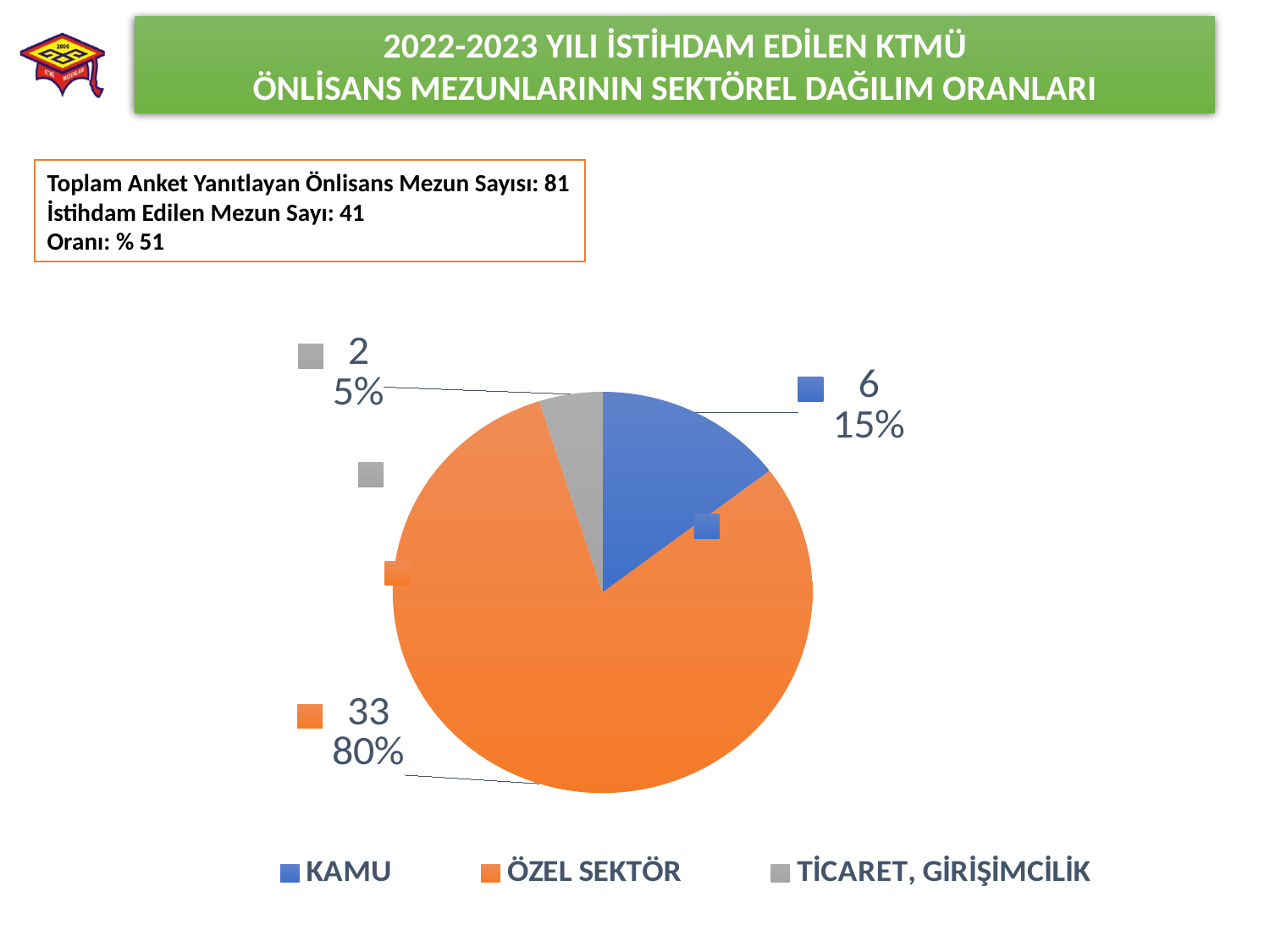
Which category has the largest slice in the pie chart? ÖZEL SEKTÖR What type of chart is shown on the slide? pie chart How many entries does the legend of the pie chart list? 3 Which category has the smallest slice in the pie chart? TİCARET, GİRİŞİMCİLİK What is the value for ÖZEL SEKTÖR in the pie chart? 33 What is the value for KAMU in the pie chart? 6 What is the value for TİCARET, GİRİŞİMCİLİK in the pie chart? 2 How many slices does the pie chart have? 3 What share of the pie does KAMU represent? 15% Which colour represents KAMU in the pie chart? blue What share of the pie does ÖZEL SEKTÖR represent? 80% What is the difference between the values for ÖZEL SEKTÖR and KAMU? 27